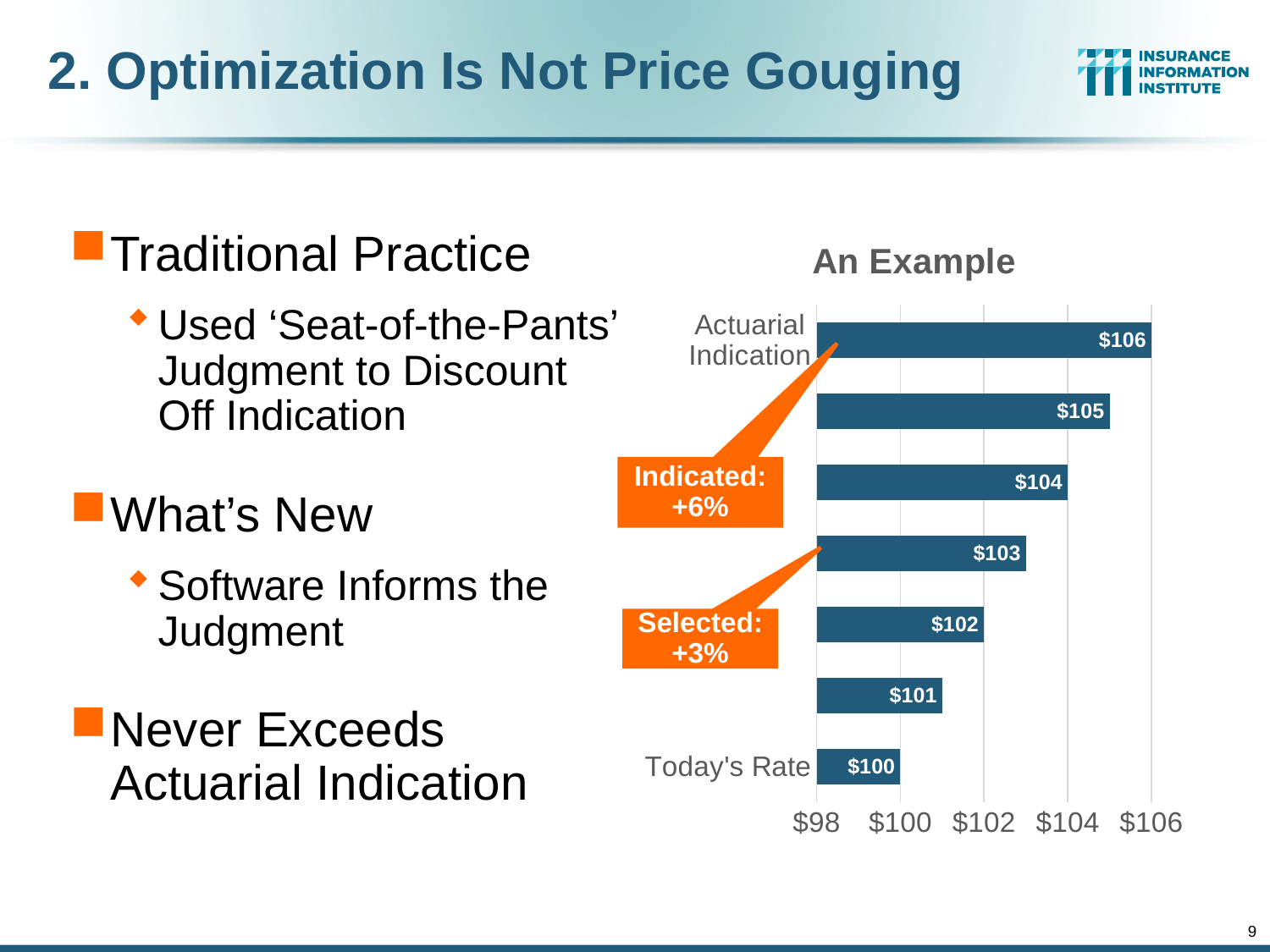
Is the value for Today's Rate in the "An Example" chart greater or less than $102? less Is the value for Actuarial Indication in the "An Example" chart greater or less than $104? greater Which category has the highest value in the "An Example" chart? Actuarial Indication What is the difference between the Actuarial Indication value and Today's Rate in the "An Example" chart? $6 What percentage does the "Selected" callout on the chart show? +3% What kind of chart is shown on the slide? Bar chart Which category has the lowest value in the "An Example" chart? Today's Rate How many bars are plotted in the "An Example" chart? 7 Which is larger in the "An Example" chart: Actuarial Indication or Today's Rate? Actuarial Indication What is the value for Today's Rate in the "An Example" chart? $100 What is the title of the chart on the slide? An Example What is the value for Actuarial Indication in the "An Example" chart? $106